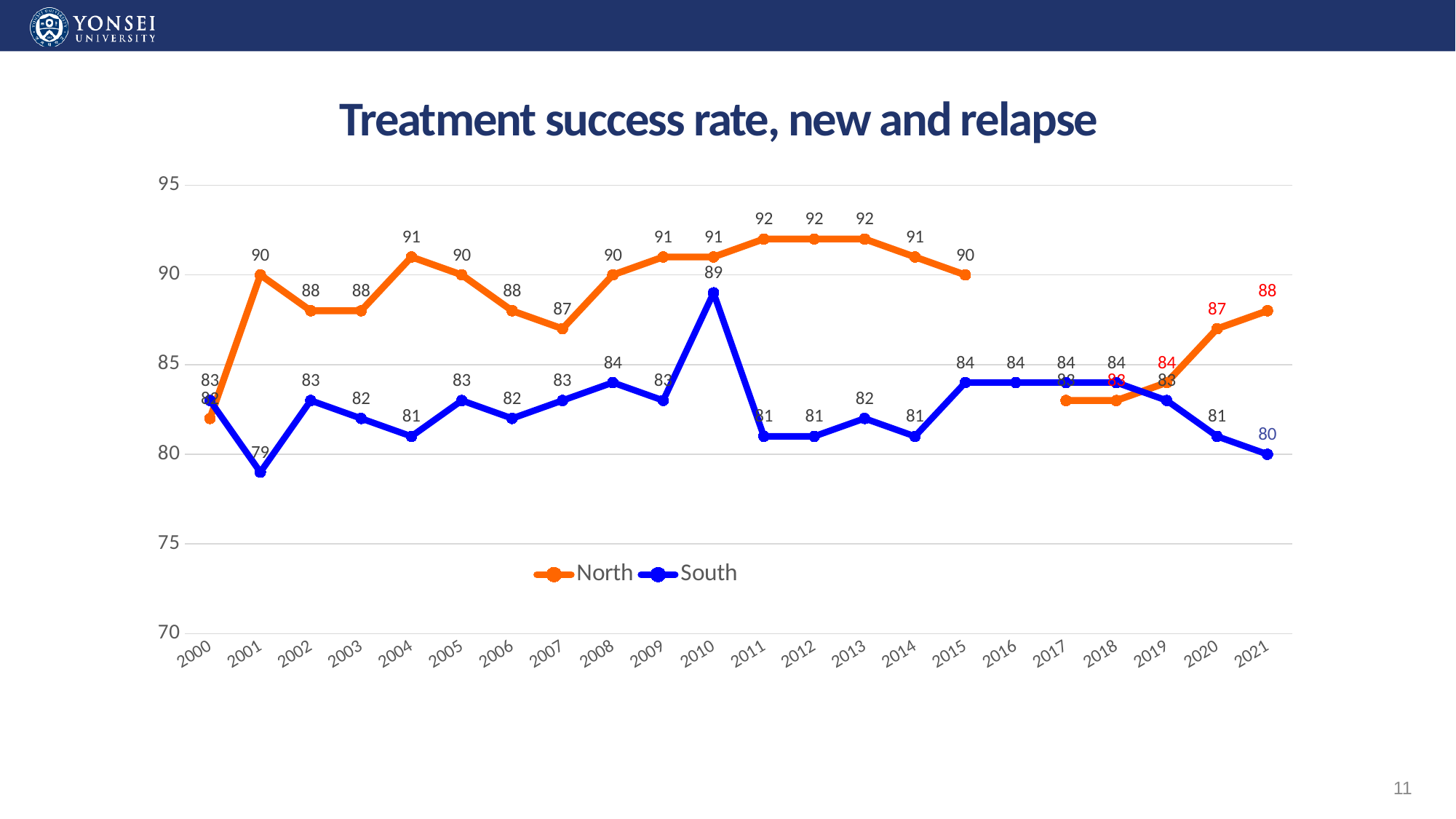
What is the value for North in 2020? 87 Which series has the higher value in 2019, North or South? North Does the South series rise or fall from 2018 to 2021? Fall What is the difference between the North and South values in 2013? 10 In which year does the South series reach its lowest value? 2001 What is the value for North in 2004? 91 What is the title of the chart? Treatment success rate, new and relapse What kind of chart is shown on the slide? Line chart How many series does the legend list? 2 What is the value for South in 2021? 80 What is the value for South in 2010? 89 In which year does the South series reach its highest value? 2010